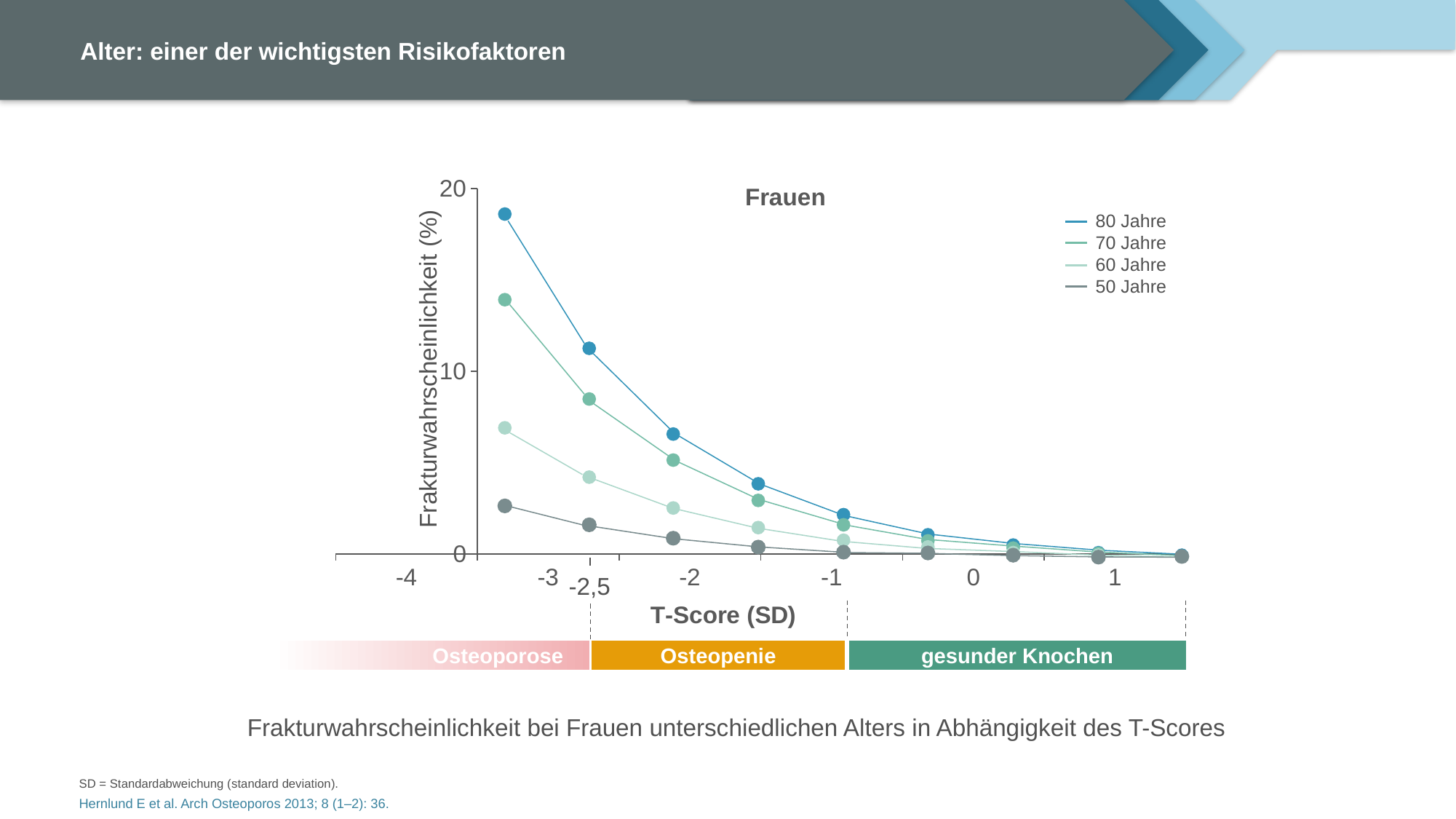
What is the title of the chart? Frauen How many series does the legend list? 4 What is the label of the x axis? T-Score (SD) Is the value for the 50 Jahre series at its leftmost point greater or less than 10? less Is the value for the 60 Jahre series at its leftmost point greater or less than 10? less Is the value for the 70 Jahre series at its leftmost point greater or less than 10? greater Do the values for the 80 Jahre series rise or fall as the T-Score increases along the x axis? fall Which series has the highest fracture probability at the leftmost point of the chart? 80 Jahre At the leftmost point of the chart, which series has the larger value: 80 Jahre or 50 Jahre? 80 Jahre Do the values for the 50 Jahre series rise or fall as the T-Score increases along the x axis? fall What kind of chart is shown on the slide? line chart